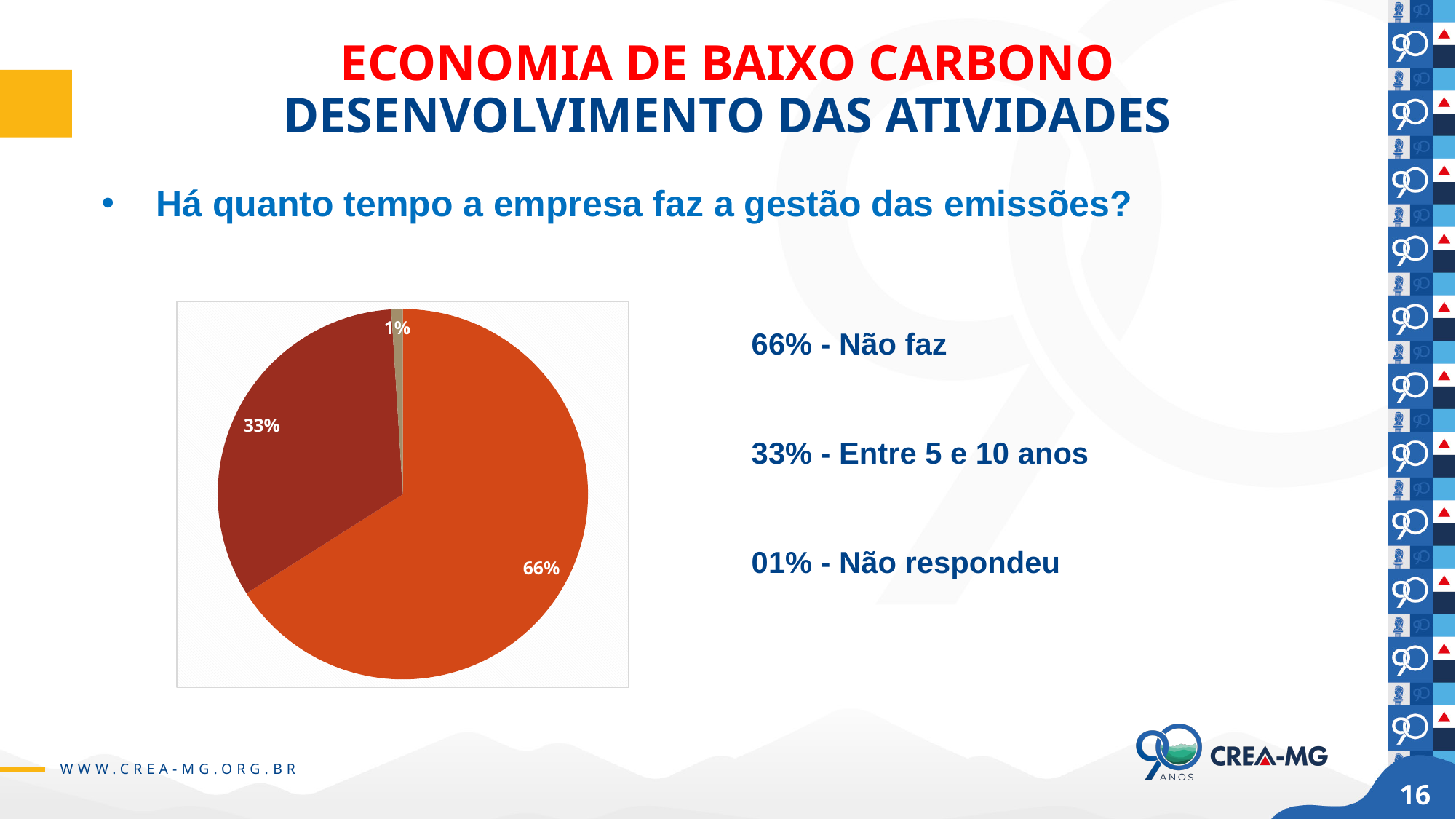
What share of the pie corresponds to "Não respondeu"? 1% Which is larger: the slice for "Entre 5 e 10 anos" or the slice for "Não respondeu"? Entre 5 e 10 anos What share of the pie corresponds to "Não faz"? 66% What kind of chart is shown on the slide? Pie chart Is the share for "Não faz" greater or less than 50%? greater What is the difference in percentage points between the "Não faz" slice and the "Entre 5 e 10 anos" slice? 33 What colour is the largest slice of the pie chart? Orange-red What question does the pie chart answer, according to the bullet text on the slide? Há quanto tempo a empresa faz a gestão das emissões? What share of the pie corresponds to "Entre 5 e 10 anos"? 33% How many slices does the pie chart have? 3 Which category has the largest slice of the pie? Não faz Which category has the smallest slice of the pie? Não respondeu